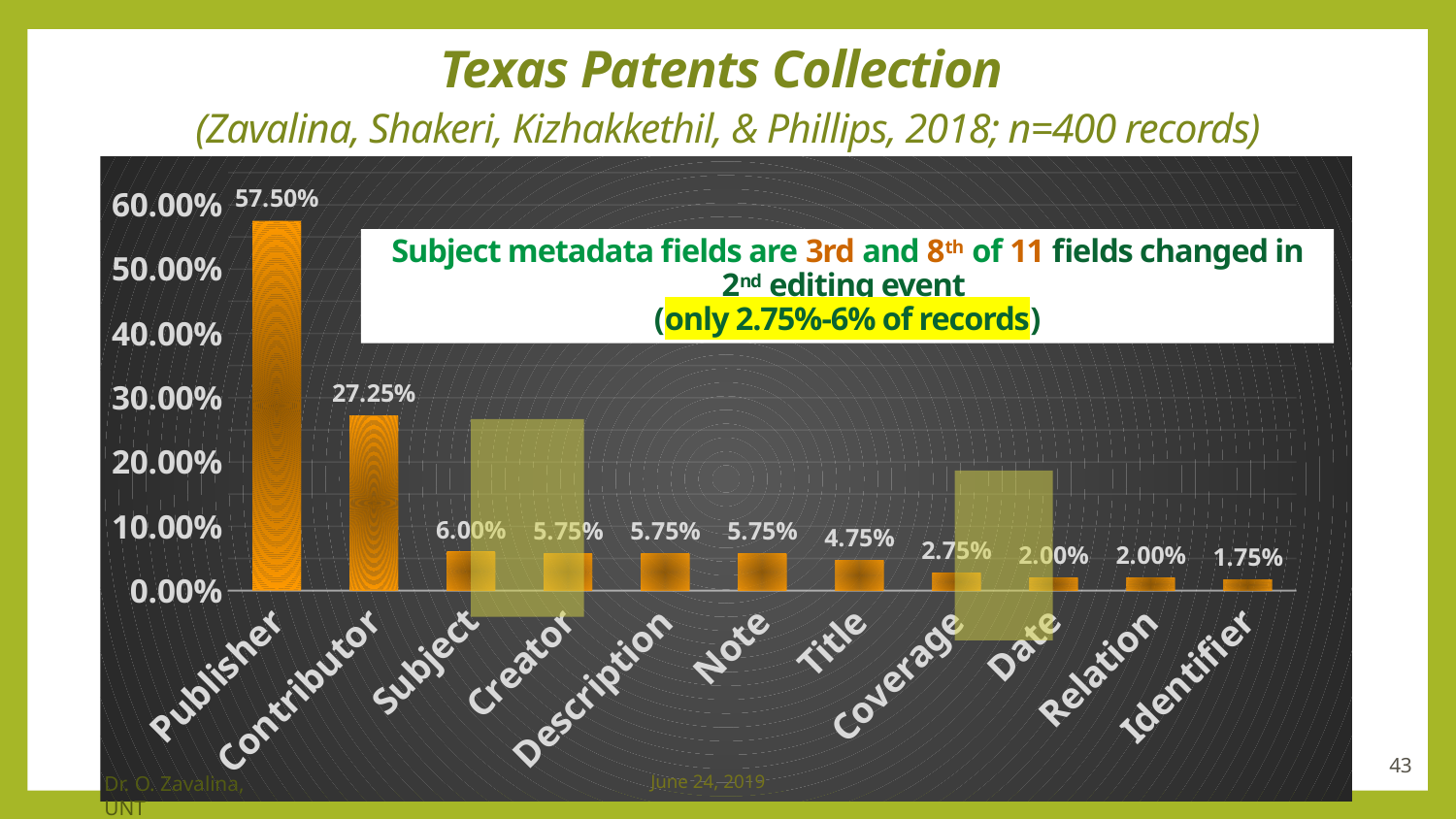
What is the value for Coverage? 2.75% What is the difference between the values for Publisher and Contributor? 30.25% What kind of chart is shown on the slide? bar chart Which is larger, the value for Title or the value for Coverage? Title What is the value for Contributor? 27.25% How many categories are shown on the x axis? 11 Is the value for Contributor greater or less than 30.00%? less What is the value for Publisher? 57.50% What is the value for Identifier? 1.75% What is the value for Subject? 6.00% Which category has the lowest value? Identifier Which category has the highest value? Publisher